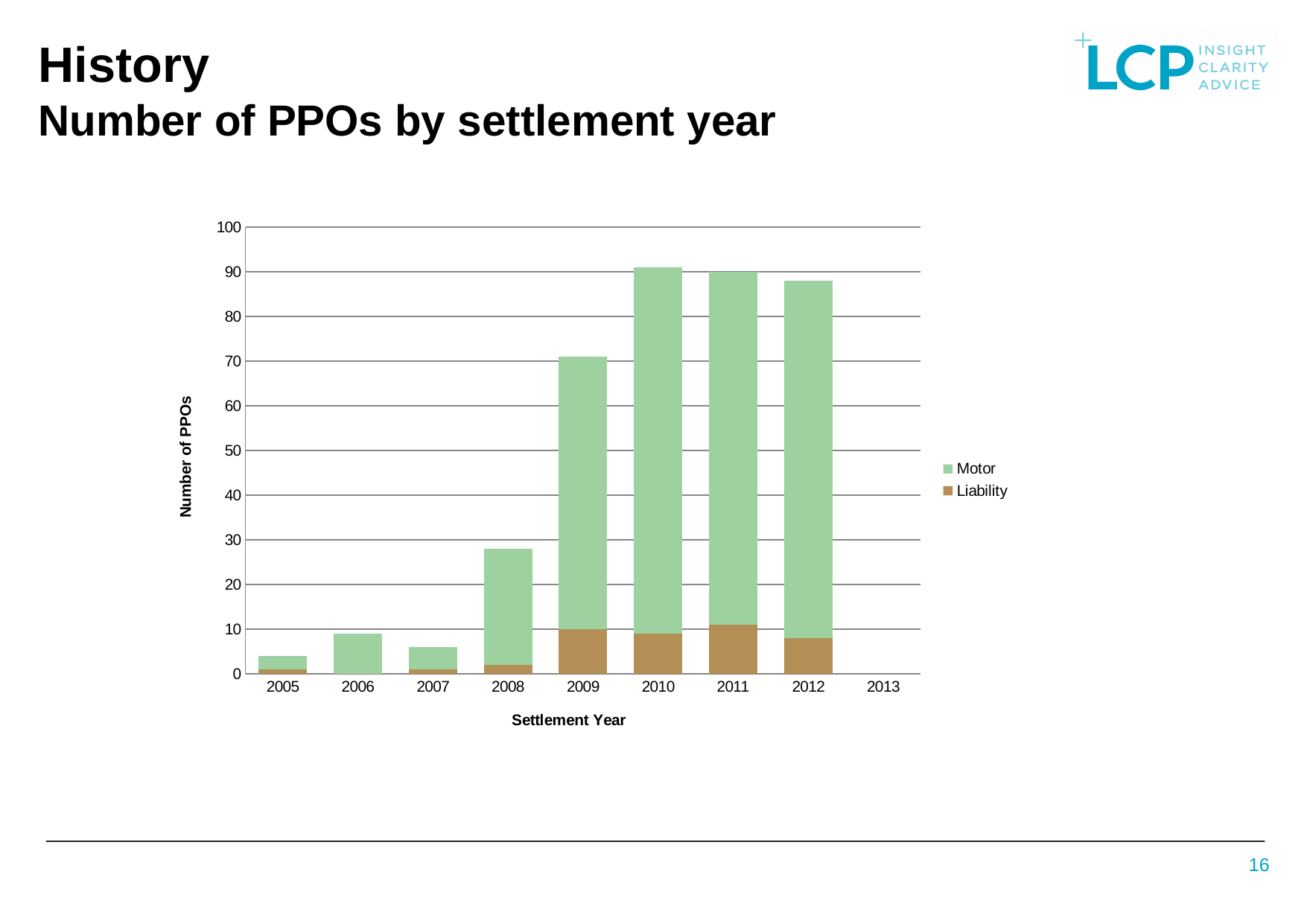
Is the total number of PPOs for 2009 greater or less than 60? greater What is the title of the y axis? Number of PPOs How many settlement years are shown on the x axis? 9 How many series does the legend list? 2 Which two series are listed in the legend? Motor and Liability Which year has the larger total number of PPOs, 2006 or 2007? 2006 Is the total number of PPOs for 2008 greater or less than 30? less Is the total number of PPOs for 2010 greater or less than 80? greater Which year has the larger total number of PPOs, 2008 or 2009? 2009 Do the total number of PPOs generally rise or fall from 2005 to 2010? rise What kind of chart is shown on the slide? bar chart